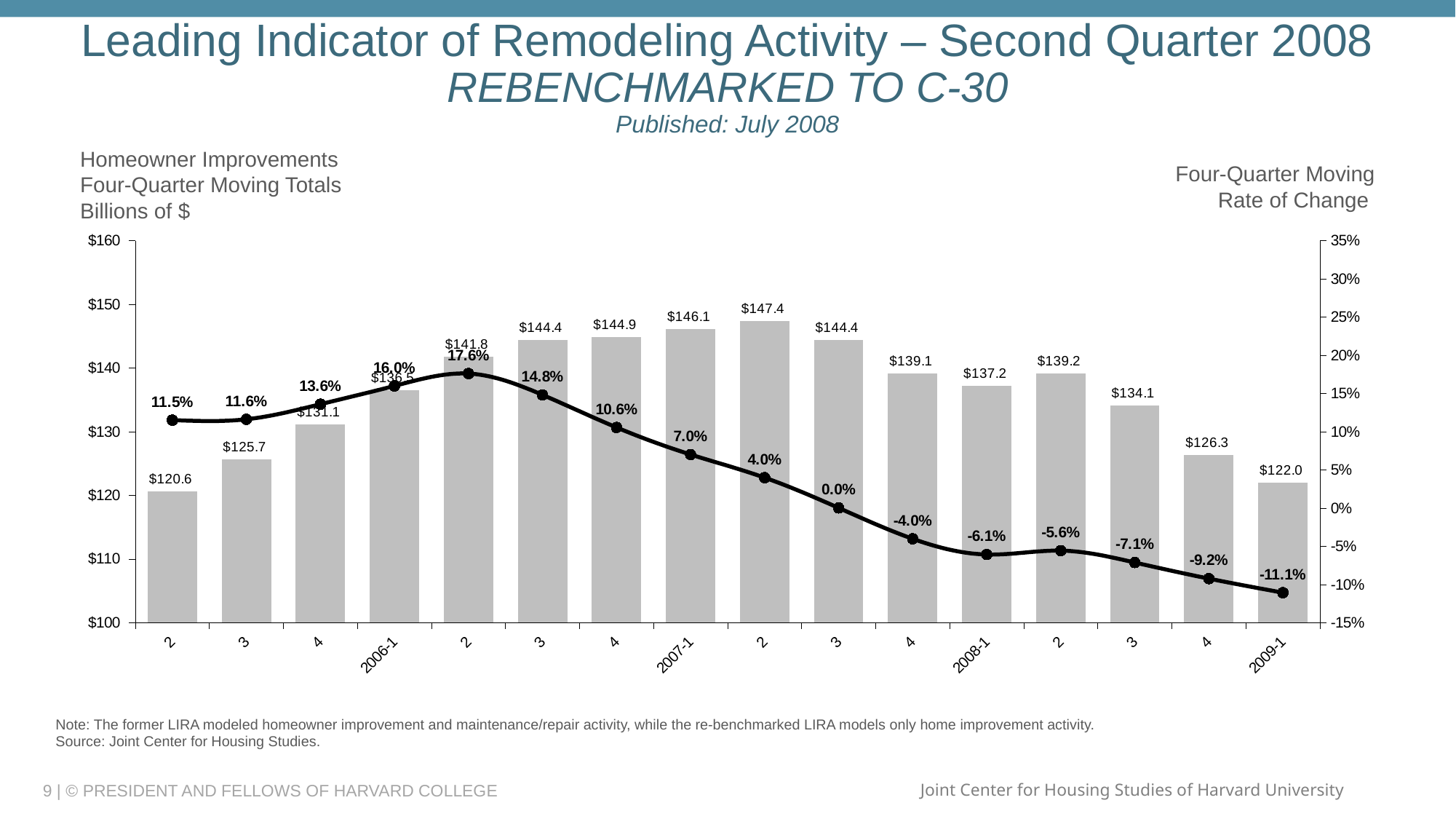
What kind of chart is shown on the slide? Combination bar and line chart Which quarter has the lowest four-quarter moving rate of change? 2009-1 (-11.1%) Which quarter has the highest four-quarter moving total? 2007 quarter 2 ($147.4) What is the four-quarter moving rate of change for 2008-1? -6.1% What is the four-quarter moving rate of change for 2006-1? 16.0% What is the four-quarter moving total for 2007-1? $146.1 What is the highest four-quarter moving rate of change shown on the line? 17.6% What is the difference between the four-quarter moving totals for 2008-1 and 2009-1? $15.2 Does the four-quarter moving rate of change line rise or fall from 2007-1 to 2009-1? Fall How many quarters are plotted on the chart? 16 Which is larger, the four-quarter moving total for 2006-1 or for 2008-1? 2008-1 What is the four-quarter moving total for 2009-1? $122.0